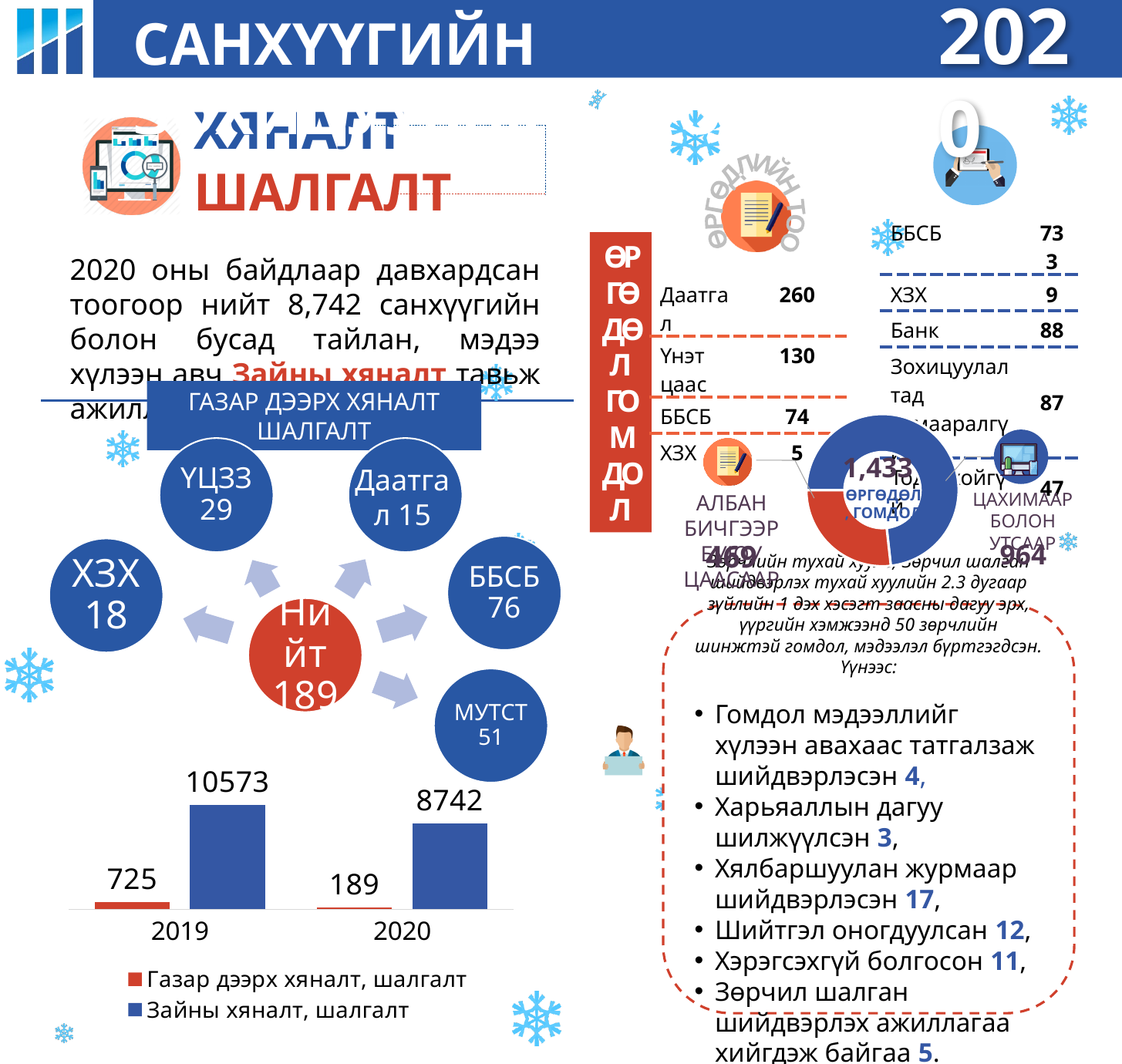
In the bar chart at the bottom left, which colour represents Зайны хяналт, шалгалт? Blue In the bar chart at the bottom left, which series is larger in 2020, Газар дээрх хяналт, шалгалт or Зайны хяналт, шалгалт? Зайны хяналт, шалгалт In the bar chart at the bottom left, what is the value of Газар дээрх хяналт, шалгалт for 2019? 725 In the bar chart at the bottom left, what is the value of Зайны хяналт, шалгалт for 2020? 8742 In the bar chart at the bottom left, does Газар дээрх хяналт, шалгалт rise or fall from 2019 to 2020? Fall In the bar chart at the bottom left, what is the value of Зайны хяналт, шалгалт for 2019? 10573 In the bar chart at the bottom left, how many series does the legend list? 2 In the bar chart at the bottom left, how many categories are shown on the x axis? 2 In the bar chart at the bottom left, what is the value of Газар дээрх хяналт, шалгалт for 2020? 189 What kind of chart is shown at the bottom left of the slide? Bar chart In the bar chart at the bottom left, what is the difference between Зайны хяналт, шалгалт in 2019 and in 2020? 1831